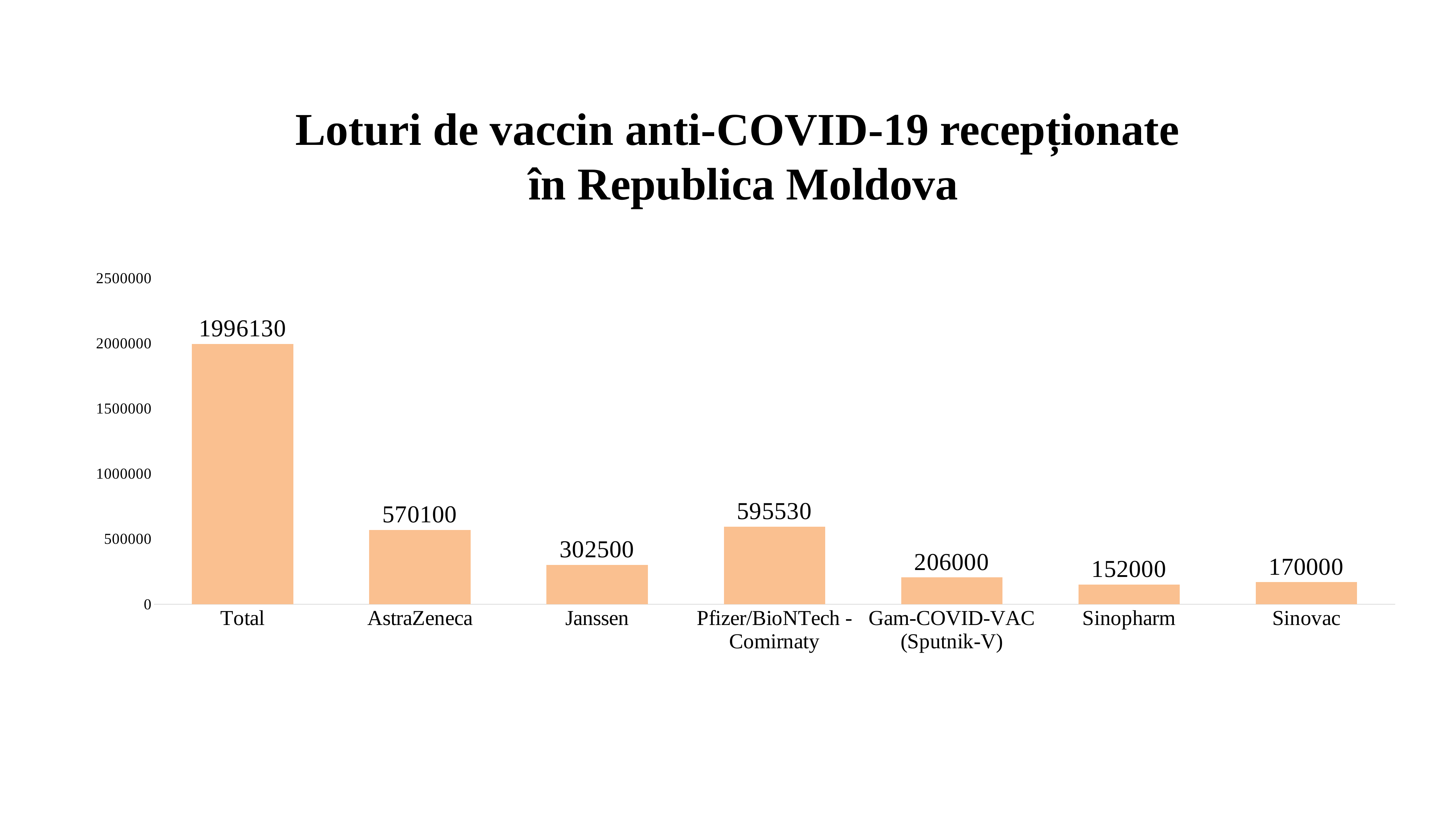
What is the value for Gam-COVID-VAC (Sputnik-V)? 206000 What is the difference between the values for Sinovac and Sinopharm? 18000 Excluding the Total bar, which vaccine has the highest value? Pfizer/BioNTech - Comirnaty What is the value for AstraZeneca? 570100 What is the title of the chart? Loturi de vaccin anti-COVID-19 recepționate în Republica Moldova What is the value for Janssen? 302500 What kind of chart is shown on the slide? Bar chart Which category has the lowest value? Sinopharm How many bars are shown in the chart? 7 Which is larger, the value for Janssen or the value for Gam-COVID-VAC (Sputnik-V)? Janssen What is the value for Sinopharm? 152000 What is the difference between the values for Pfizer/BioNTech - Comirnaty and AstraZeneca? 25430